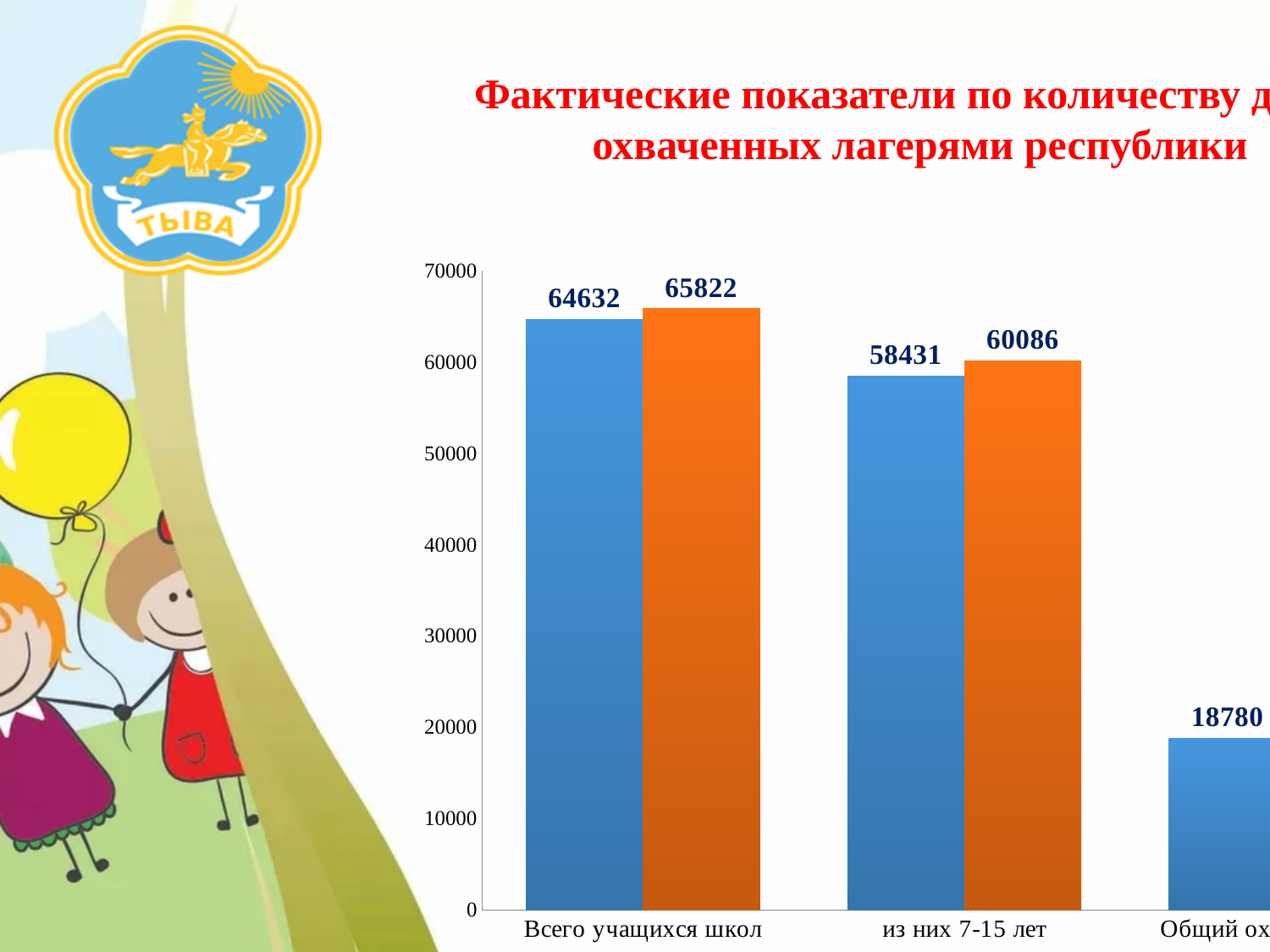
What kind of chart is shown on the slide? bar chart Is the blue bar for "из них 7-15 лет" greater or less than 60000? less What is the difference between the blue bars for "Всего учащихся школ" and "из них 7-15 лет"? 6201 Which labelled bar has the highest value on the chart? the orange bar for "Всего учащихся школ" (65822) What is the value of the blue bar for "из них 7-15 лет"? 58431 What is the difference between the orange and blue bars for "из них 7-15 лет"? 1655 What is the value of the blue bar for "Всего учащихся школ"? 64632 What two colours are used for the bars in the chart? blue and orange For "Всего учащихся школ", which bar is larger, the blue or the orange one? the orange one (65822) What is the value of the orange bar for "Всего учащихся школ"? 65822 What is the value of the orange bar for "из них 7-15 лет"? 60086 By how much does the orange bar exceed the blue bar for "Всего учащихся школ"? 1190